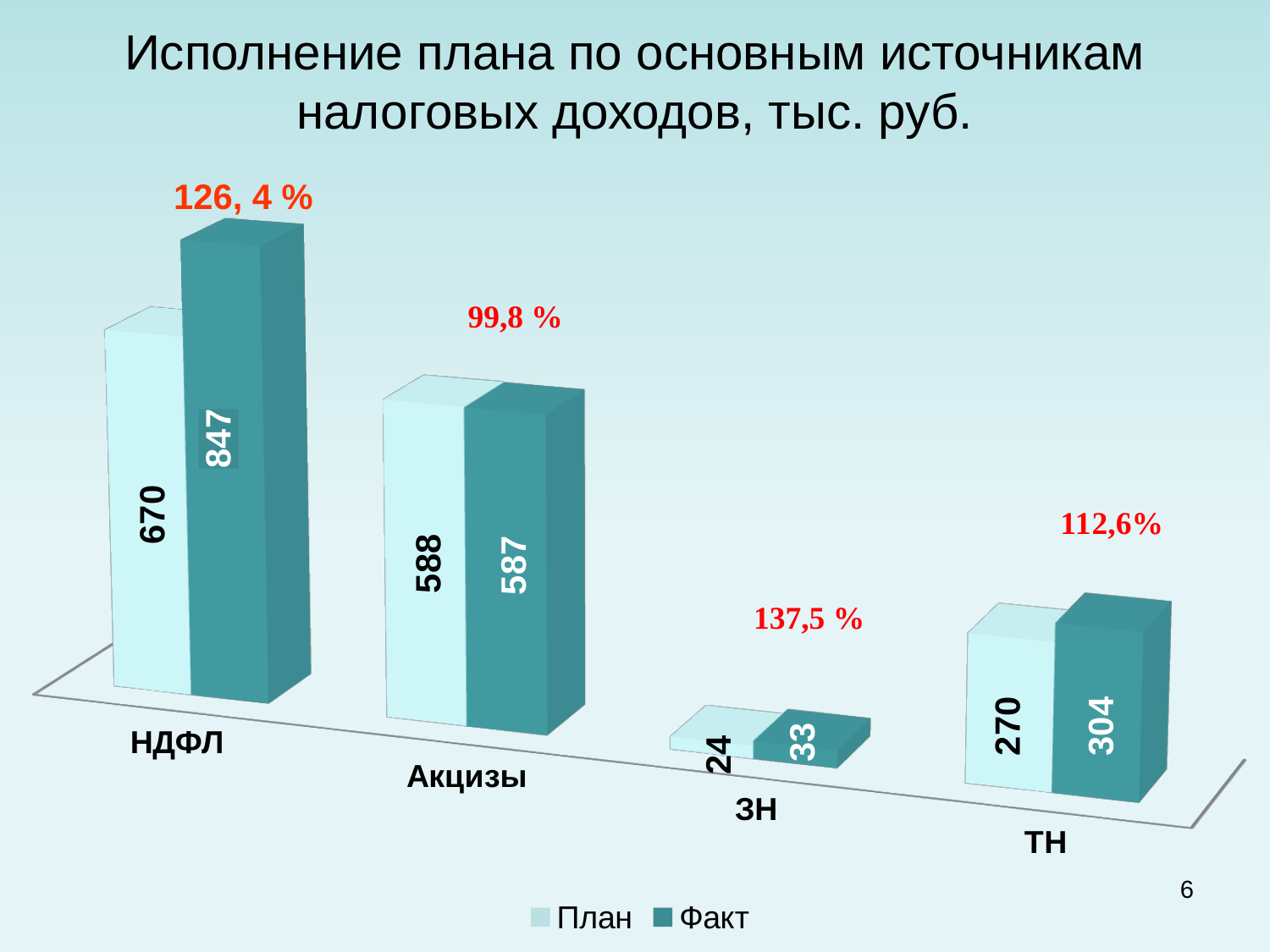
What is the Факт value for НДФЛ? 847 What percentage is printed above the ЗН bars? 137,5 % Which category has the highest План value? НДФЛ What kind of chart is shown on the slide? Bar chart Which is larger for ТН, the План value or the Факт value? Факт Which category has the lowest Факт value? ЗН What is the Факт value for Акцизы? 587 What is the План value for ТН? 270 What is the План value for НДФЛ? 670 How many categories are shown on the x axis? 4 How many series does the legend list? 2 What is the difference between the Факт and План values for НДФЛ? 177